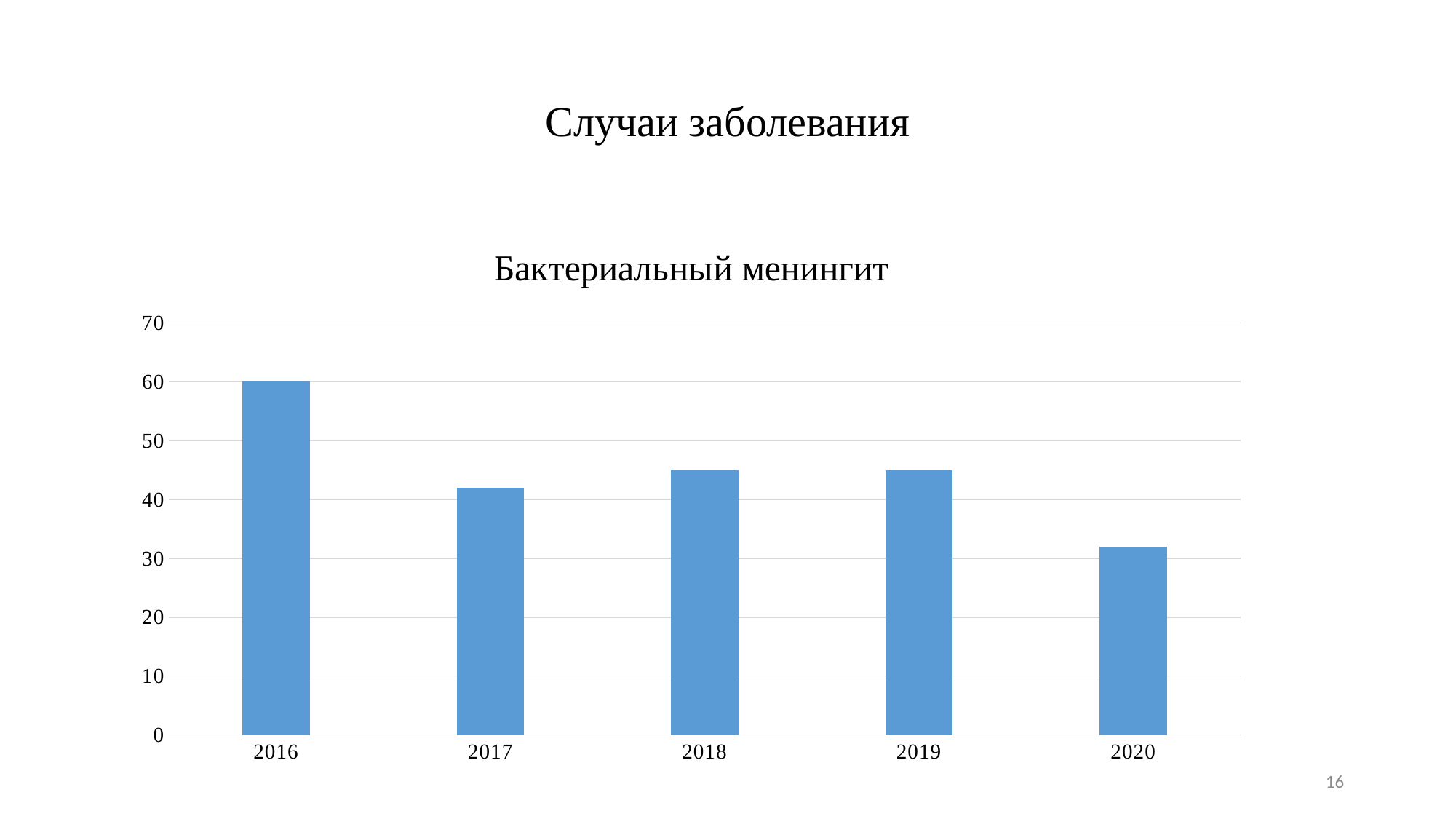
Which year has the highest value? 2016 Which is larger, the value for 2016 or the value for 2017? 2016 What type of chart is shown on the slide? bar chart Which is larger, the value for 2018 or the value for 2020? 2018 Is the value for 2020 greater or less than 40? less Is the value for 2017 greater or less than 40? greater How many years are shown on the x axis of the chart? 5 Is the value for 2019 greater or less than 50? less Overall, do the values rise or fall from 2016 to 2020? fall Which year has the lowest value? 2020 What is the value for 2016? 60 What is the title of the chart? Бактериальный менингит